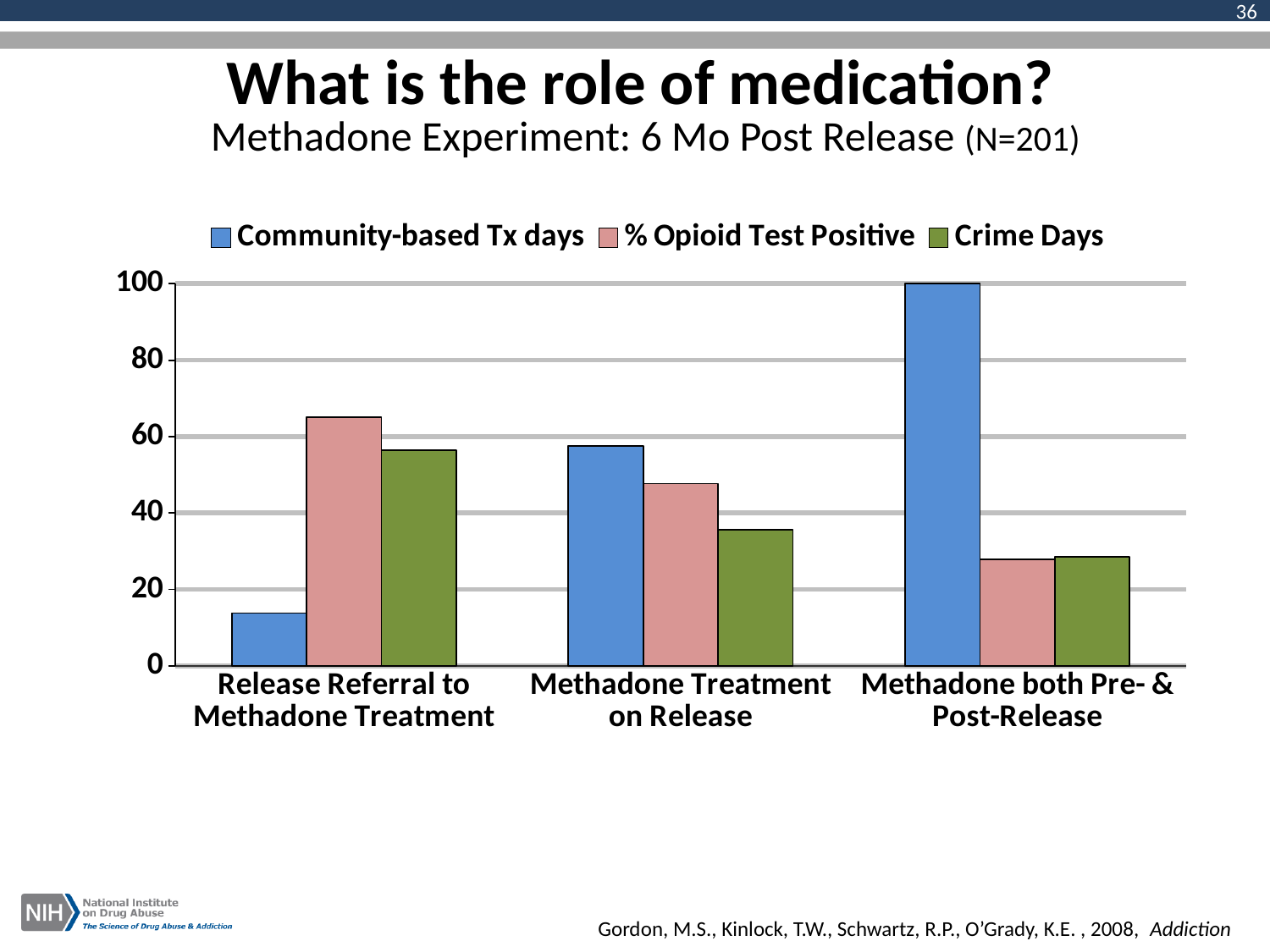
Which category has the highest value for Community-based Tx days? Methadone both Pre- & Post-Release Which is larger for Methadone Treatment on Release: Community-based Tx days or Crime Days? Community-based Tx days How many series does the legend list? 3 Is the value of % Opioid Test Positive for Release Referral to Methadone Treatment greater or less than 60? greater How many categories are shown on the x axis? 3 Is the value of Community-based Tx days for Release Referral to Methadone Treatment greater or less than 20? less Do the Crime Days values rise or fall across the categories from left to right? fall What kind of chart is shown on the slide? bar chart Which category has the lowest value for Community-based Tx days? Release Referral to Methadone Treatment Which category has the highest value for % Opioid Test Positive? Release Referral to Methadone Treatment Is the value of Crime Days for Methadone Treatment on Release greater or less than 40? less